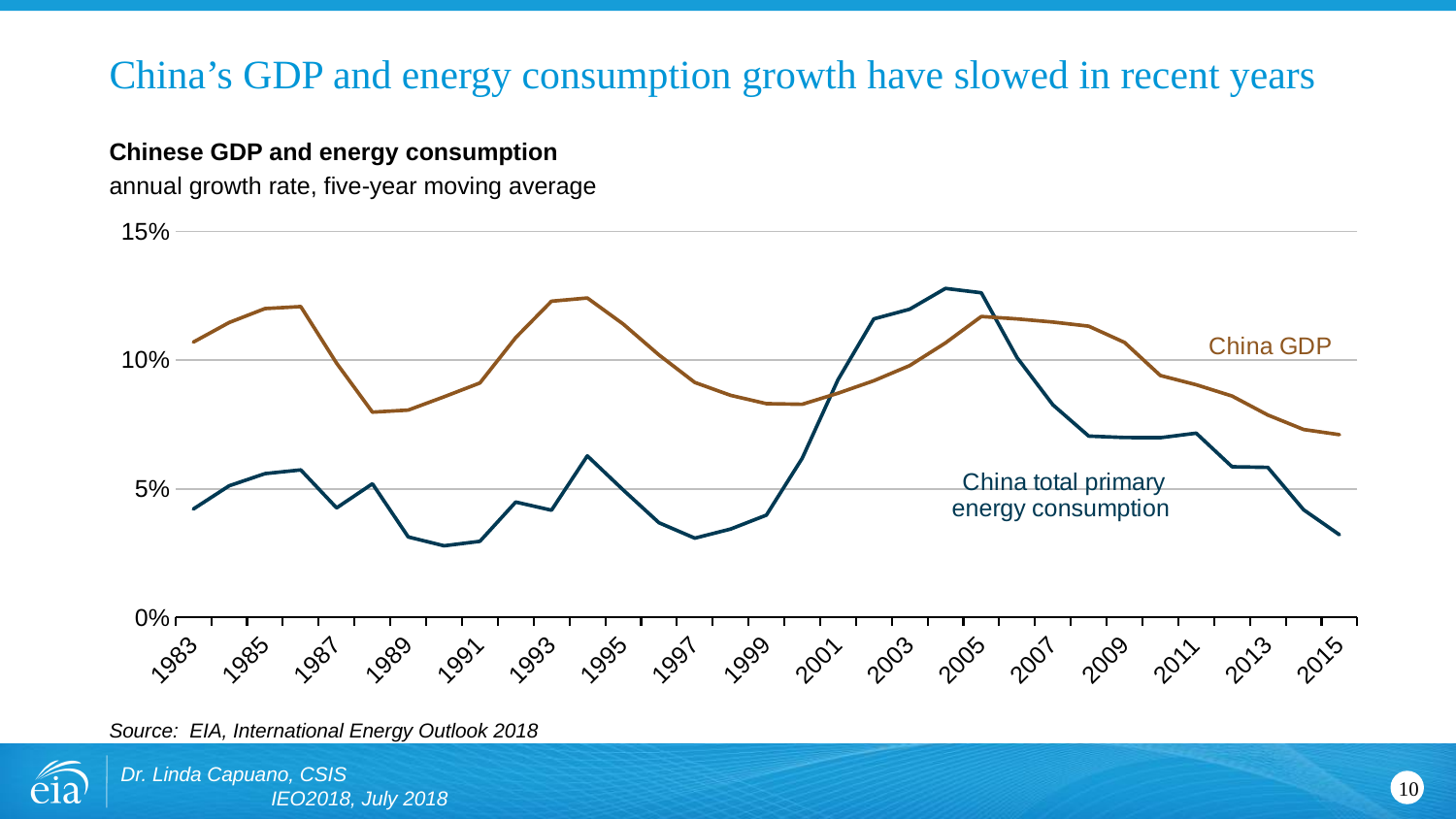
Does the China total primary energy consumption line rise or fall between 2005 and 2015? fall Is the value for China GDP in 1989 greater or less than 5%? greater What kind of chart is shown on the slide? line chart In 2005, which series has the higher value, China GDP or China total primary energy consumption? China total primary energy consumption Is the value for China total primary energy consumption in 2015 greater or less than 5%? less How many series are plotted on the chart? 2 What is the title of the chart? Chinese GDP and energy consumption What measure does the chart's subtitle say is plotted? annual growth rate, five-year moving average Is the value for China total primary energy consumption in 2005 greater or less than 10%? greater In 1995, which series has the higher value, China GDP or China total primary energy consumption? China GDP How many year labels are shown on the x axis? 17